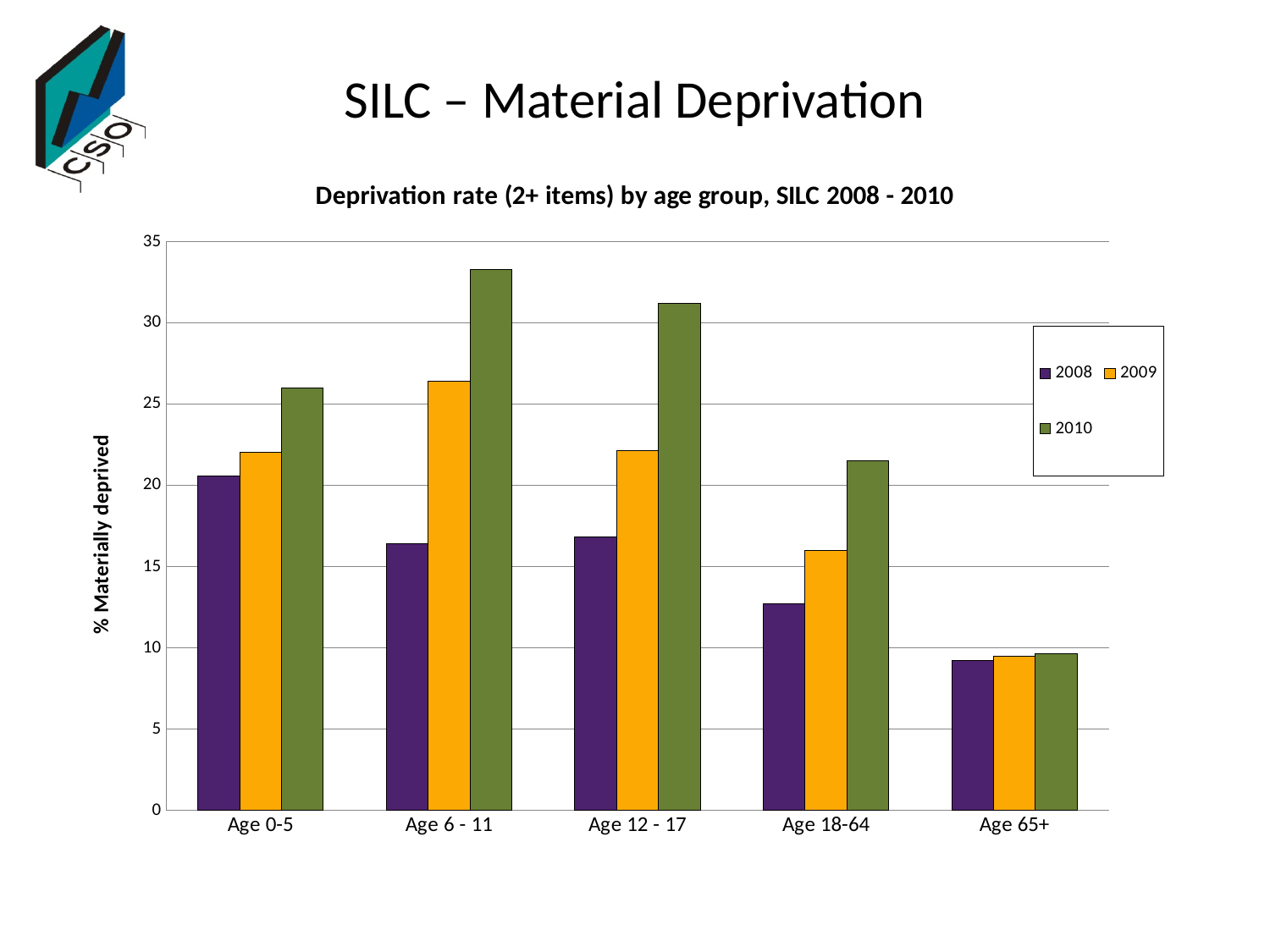
Within the Age 18-64 group, do the values rise or fall from 2008 to 2010? rise What kind of chart is shown on the slide? bar chart How many age groups are shown on the x axis? 5 For 2009, which is larger: the value for Age 0-5 or the value for Age 6 - 11? Age 6 - 11 Which age group has the highest deprivation rate for 2008? Age 0-5 Is the 2008 value for Age 18-64 greater or less than 15? less Is the 2010 value for Age 6 - 11 greater or less than 30? greater Is the 2010 value for Age 65+ greater or less than 10? less Which age group has the lowest deprivation rate for 2008? Age 65+ What is the label on the y axis of the chart? % Materially deprived Which age group has the highest deprivation rate for 2010? Age 6 - 11 How many series does the legend list? 3